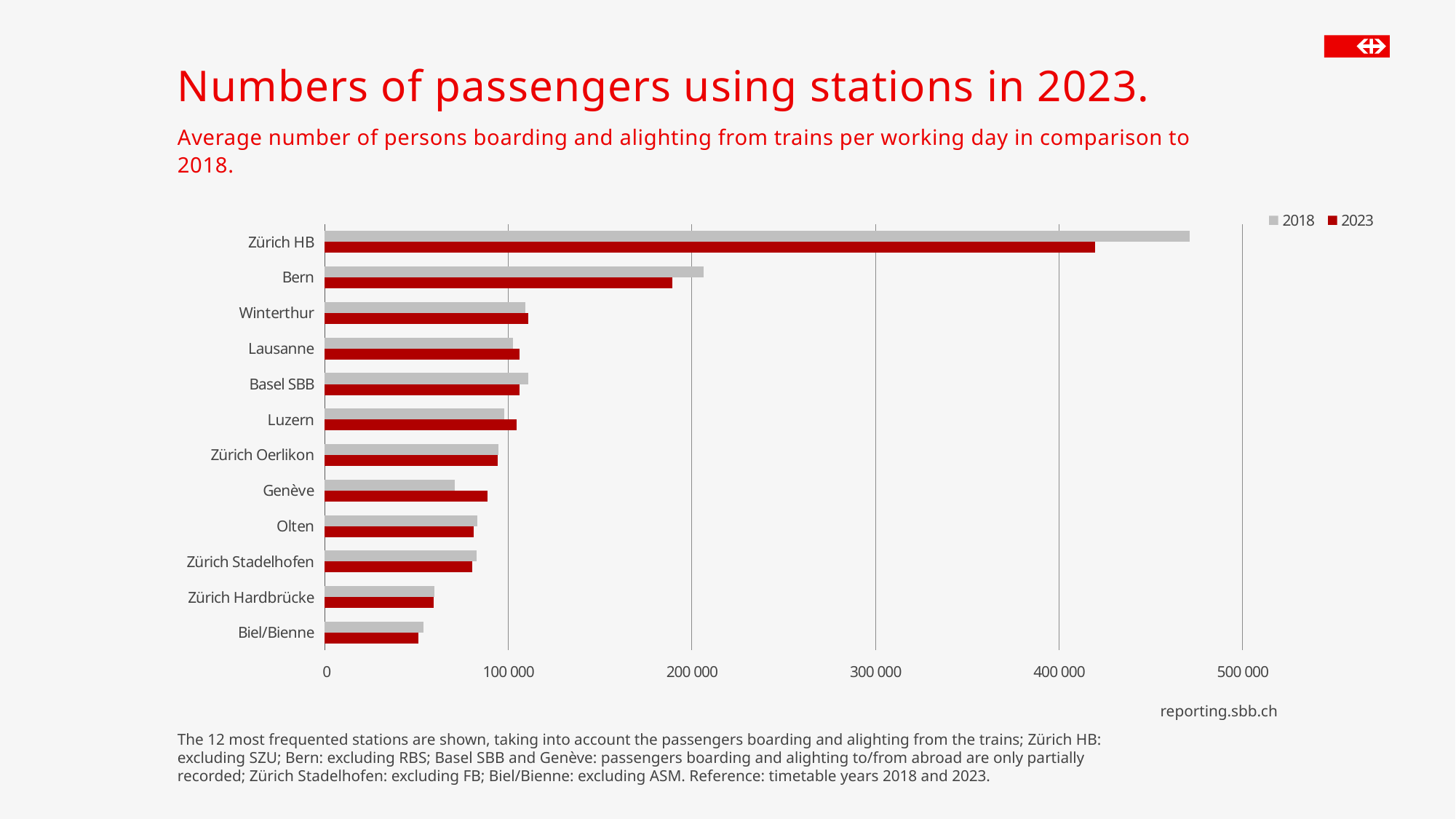
For Genève, which year has the larger value, 2018 or 2023? 2023 Which colour represents the 2023 series in the chart? Red What kind of chart is shown on the slide? Bar chart Which station has the lowest number of passengers in 2023? Biel/Bienne Is the 2018 value for Zürich HB greater or less than 500 000? less How many stations are shown in the chart? 12 For Zürich HB, which year has the larger value, 2018 or 2023? 2018 Which station has the highest number of passengers in 2023? Zürich HB Is the 2023 value for Zürich HB greater or less than 400 000? greater Is the 2023 value for Bern greater or less than 200 000? less How many series does the legend list? 2